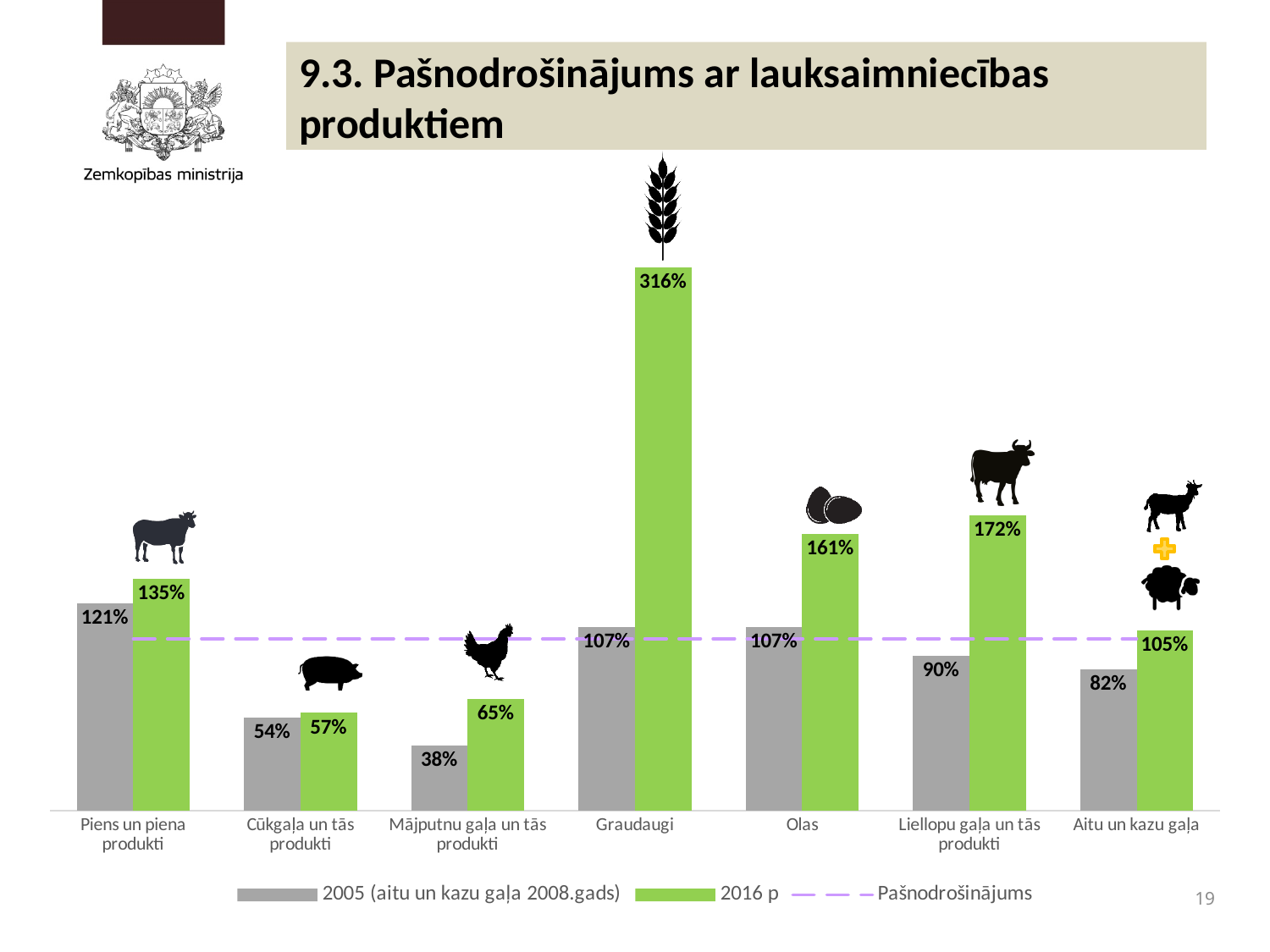
Which is larger for Cūkgaļa un tās produkti: the 2005 value or the 2016 p value? 2016 p Which category has the lowest 2005 value? Mājputnu gaļa un tās produkti What is the 2016 p value for Liellopu gaļa un tās produkti? 172% What type of chart is shown on the slide? Bar chart How many product categories are shown on the x axis? 7 What is the 2005 value for Mājputnu gaļa un tās produkti? 38% What is the label of the dashed line in the legend? Pašnodrošinājums Which category has the highest 2016 p value? Graudaugi What is the difference between the 2016 p and 2005 values for Olas? 54% What is the 2016 p value for Graudaugi? 316% What is the 2005 value for Aitu un kazu gaļa? 82% How many entries does the legend list? 3